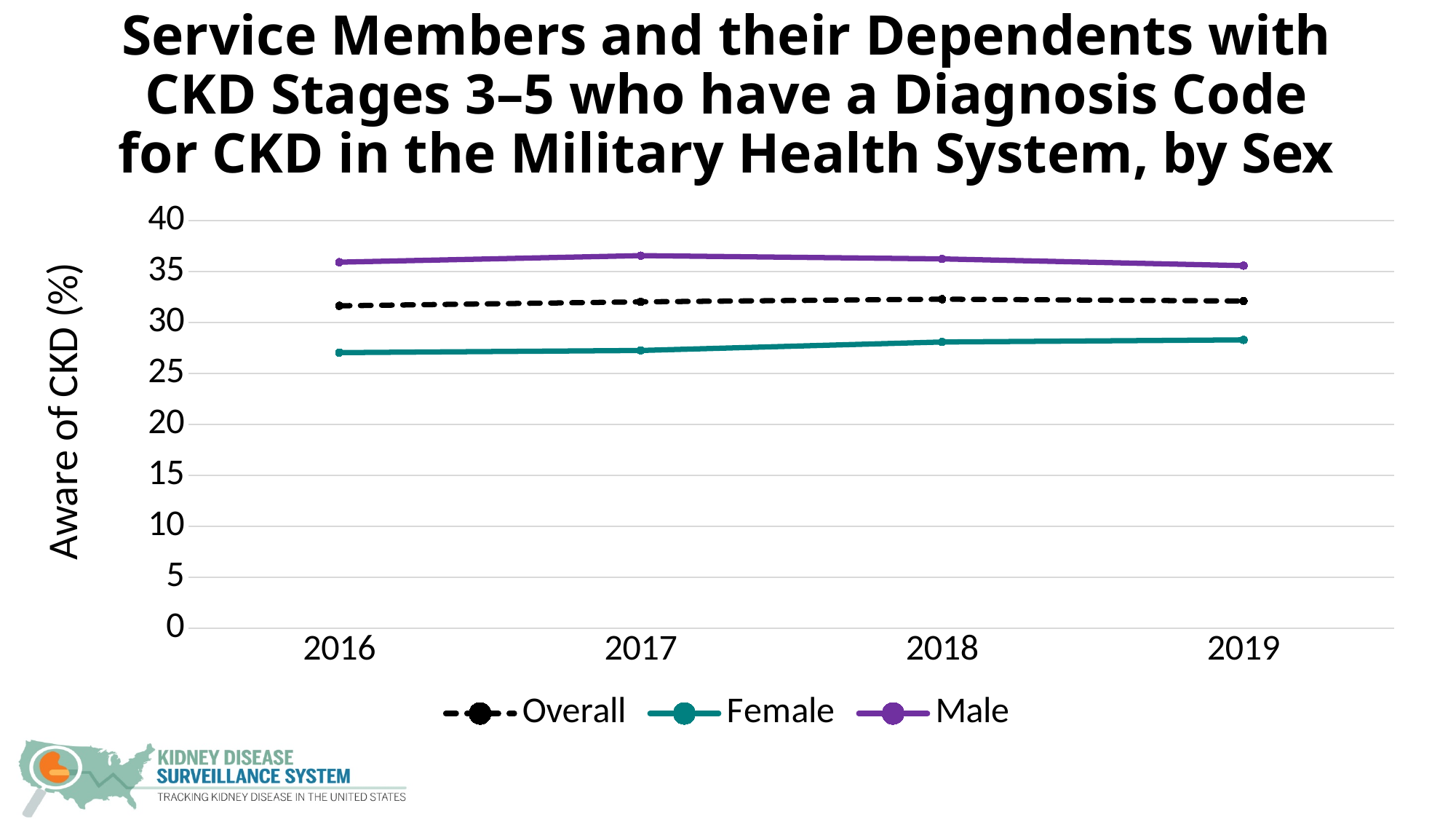
Is the value for Male in 2017 greater or less than 35? greater Which series has the lowest values across all years? Female Is the value for Female in 2016 greater or less than 30? less Which series is drawn with a dashed line? Overall In 2019, which is larger: the value for Male or the value for Female? Male Is the value for Overall in 2018 greater or less than 30? greater How many years are plotted along the x axis? 4 Which series has the highest values across all years? Male What kind of chart is shown on the slide? line chart What is the label on the y axis? Aware of CKD (%) How many series does the legend list? 3 Does the Female line rise or fall from 2016 to 2019? rise